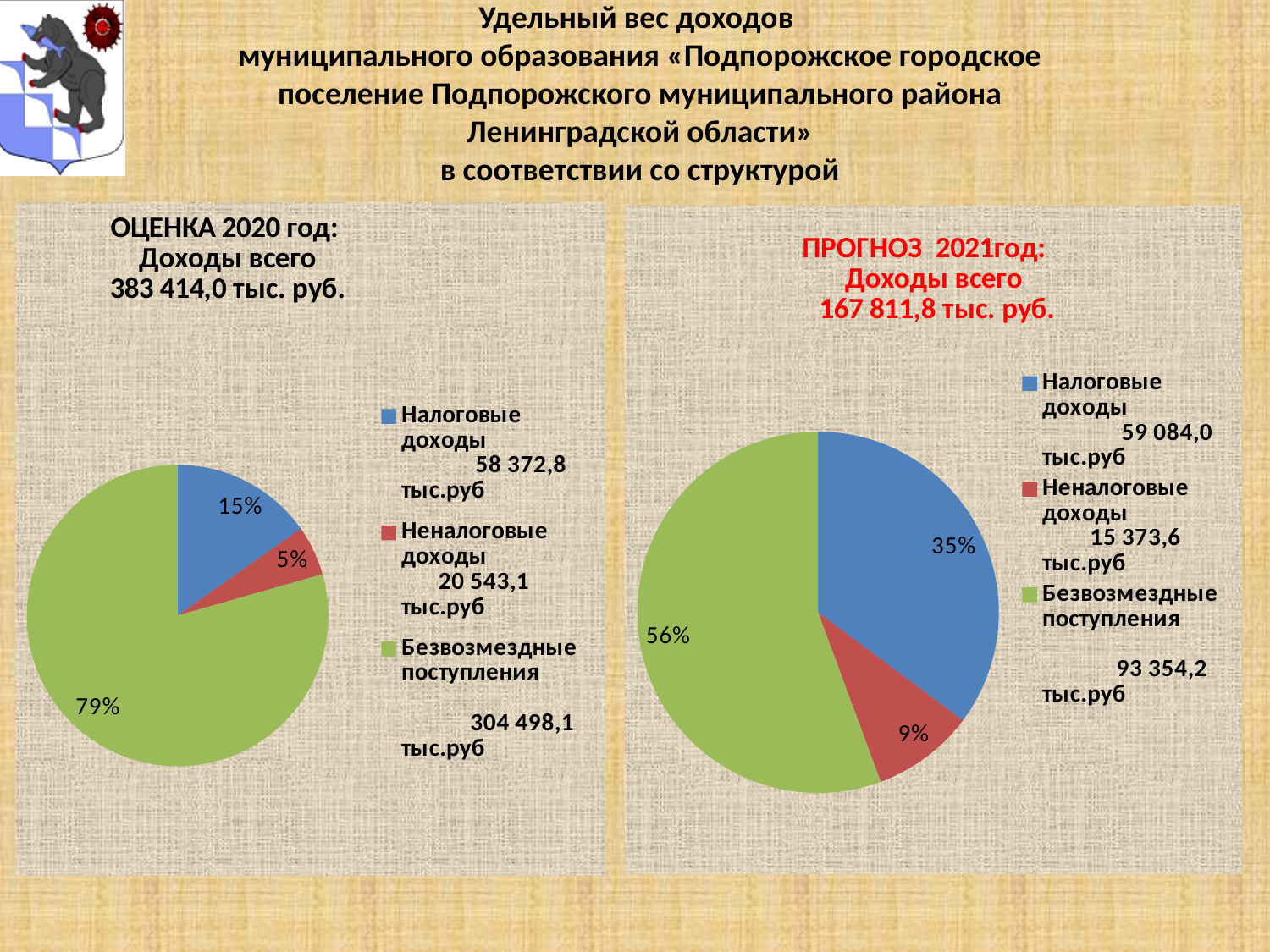
In the right chart (ПРОГНОЗ 2021год), what amount in тыс.руб is listed in the legend for Безвозмездные поступления? 93 354,2 тыс.руб How many categories does the legend of the right chart (ПРОГНОЗ 2021год) list? 3 What type of chart is used on the left side of the slide (ОЦЕНКА 2020 год)? Pie chart In the right chart (ПРОГНОЗ 2021год), what percentage is shown for Налоговые доходы? 35% What total income (Доходы всего) is stated above the right chart (ПРОГНОЗ 2021год)? 167 811,8 тыс. руб. In the right chart (ПРОГНОЗ 2021год), which category has the largest slice? Безвозмездные поступления In the left chart (ОЦЕНКА 2020 год), what share of the pie is Безвозмездные поступления? 79% In the left chart (ОЦЕНКА 2020 год), which category has the smallest slice? Неналоговые доходы In the left chart (ОЦЕНКА 2020 год), what percentage is shown for Налоговые доходы? 15% Which is larger: the Неналоговые доходы share in the left chart (2020) or in the right chart (2021)? Right chart (2021), 9% In the right chart (ПРОГНОЗ 2021год), what is the difference in percentage points between Безвозмездные поступления and Налоговые доходы? 21 percentage points In the left chart (ОЦЕНКА 2020 год), what amount in тыс.руб is listed in the legend for Неналоговые доходы? 20 543,1 тыс.руб